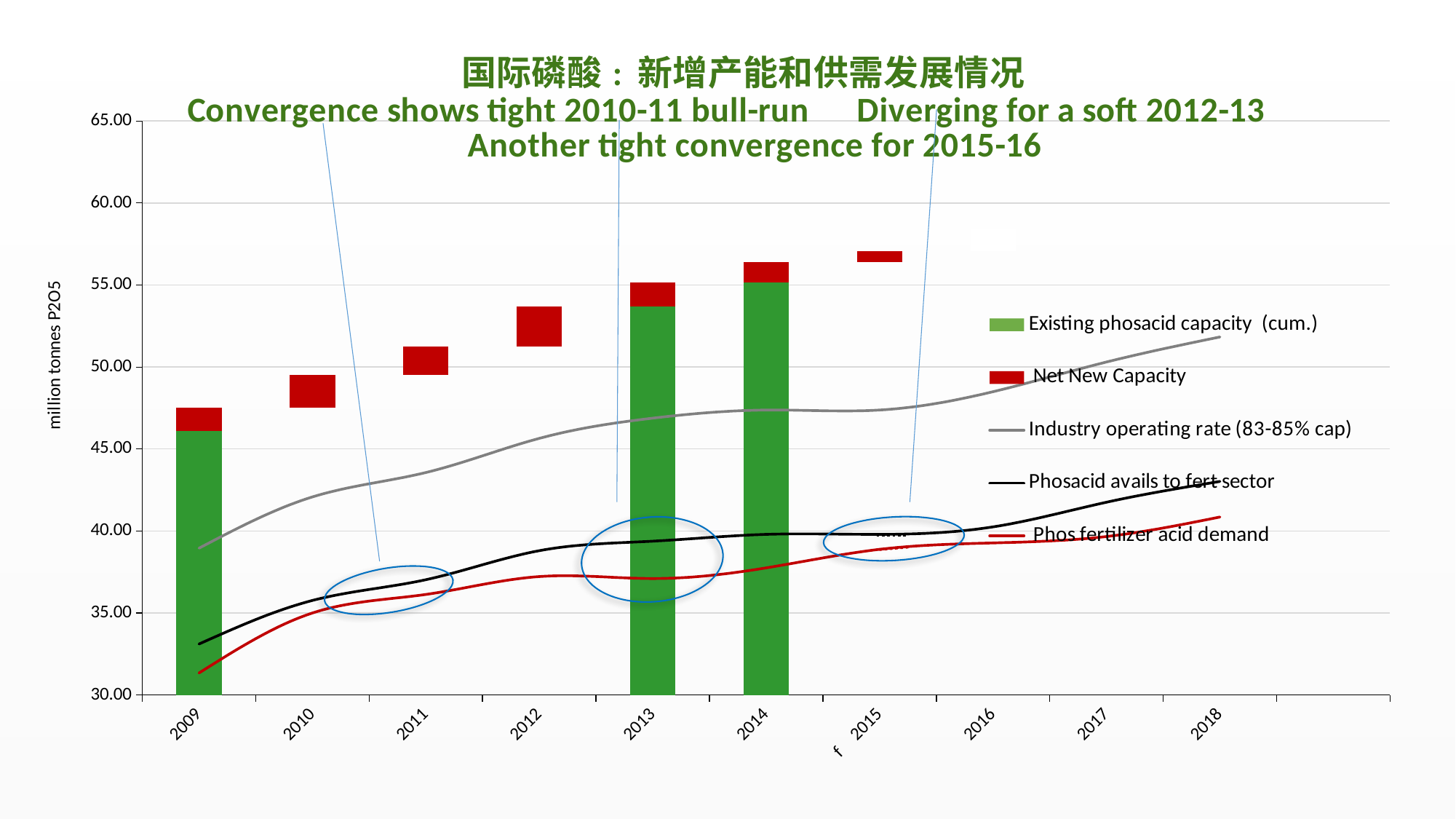
In 2009, which is higher: Phosacid avails to fert sector or Phos fertilizer acid demand? Phosacid avails to fert sector How many years are shown on the x axis? 10 How many series does the legend list? 5 What is the label on the vertical axis? million tonnes P2O5 Is the Phosacid avails to fert sector value for 2018 greater or less than 40.00? greater What kind of chart is this? Combined bar and line chart Which year has the taller Existing phosacid capacity (cum.) bar, 2009 or 2014? 2014 Is the Existing phosacid capacity (cum.) bar for 2013 greater or less than 50.00? greater Does the Industry operating rate line rise or fall from 2009 to 2018? rise Is the Industry operating rate value for 2018 greater or less than 50.00? greater What colour represents Net New Capacity in the legend? Red